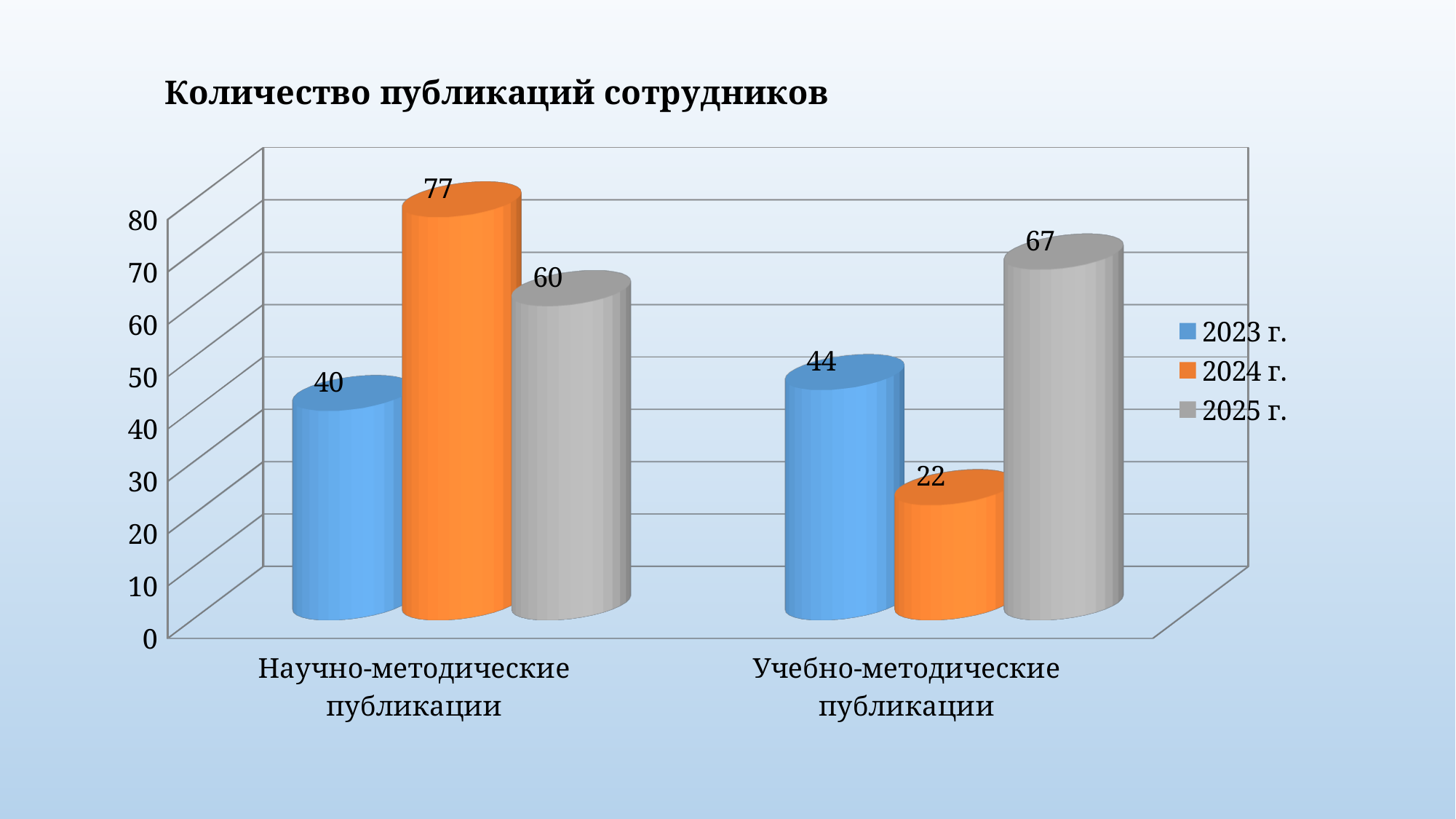
Which series has the highest value in the Научно-методические публикации category? 2024 г. Which series has the lowest value in the Учебно-методические публикации category? 2024 г. How many categories are shown on the x axis? 2 Which is larger: the 2025 г. value for Научно-методические публикации or the 2025 г. value for Учебно-методические публикации? Учебно-методические публикации What is the difference between the 2024 г. and 2023 г. values for Научно-методические публикации? 37 What is the value for 2025 г. in the Учебно-методические публикации category? 67 What is the title of the chart? Количество публикаций сотрудников What is the value for 2024 г. in the Научно-методические публикации category? 77 How many series does the legend list? 3 What is the value for 2024 г. in the Учебно-методические публикации category? 22 What is the value for 2023 г. in the Научно-методические публикации category? 40 What is the difference between the 2025 г. and 2024 г. values for Учебно-методические публикации? 45